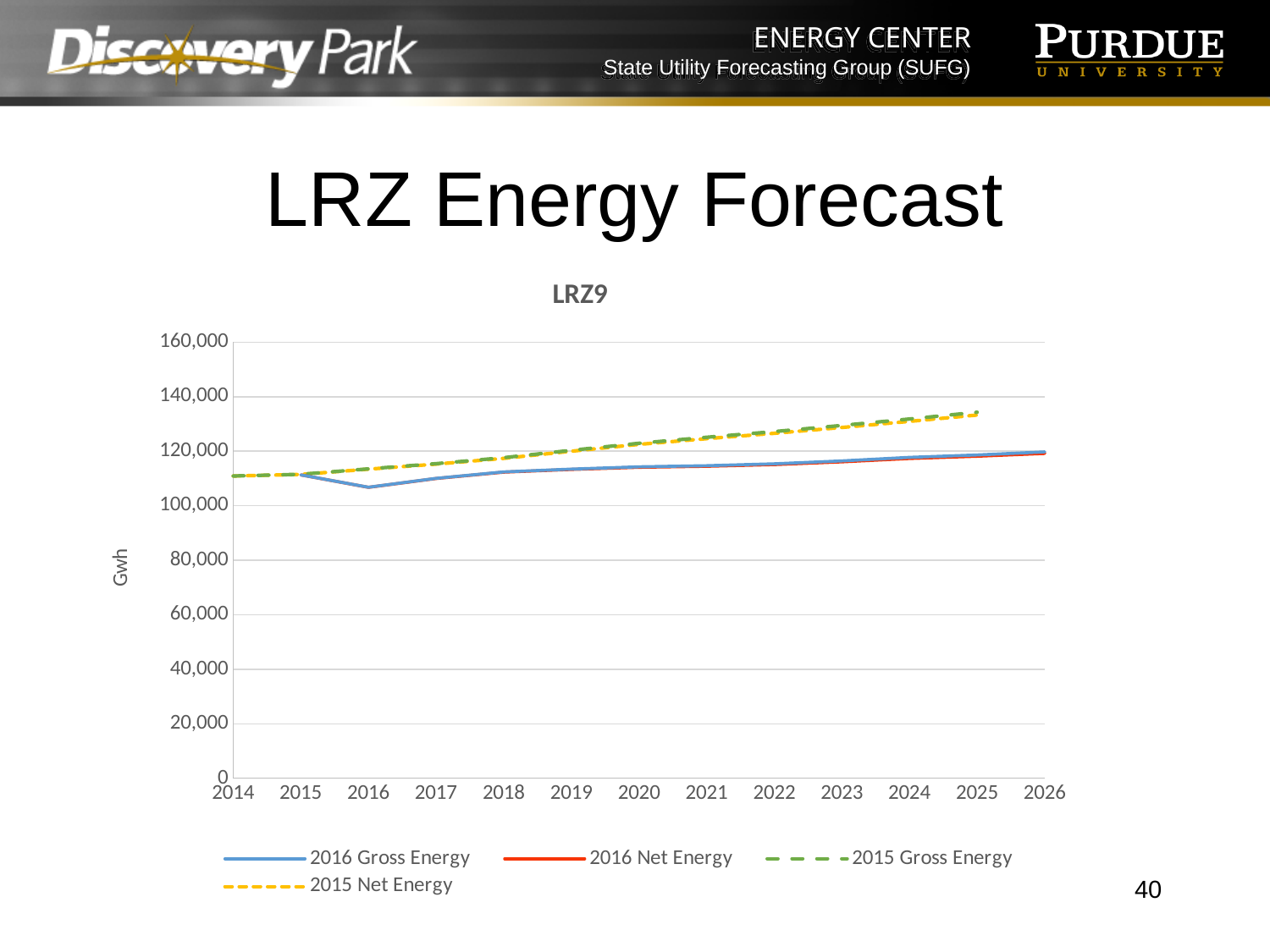
What is the title of the chart? LRZ9 Is the value for 2015 Gross Energy in 2025 greater or less than 140,000? less How many series does the legend list? 4 What kind of chart is shown on the slide? line chart Does the 2016 Net Energy series rise or fall from 2016 to 2026? rise Does the 2015 Gross Energy series rise or fall from 2014 to 2025? rise In 2025, which is larger: 2015 Gross Energy or 2016 Gross Energy? 2015 Gross Energy In which year is the 2016 Gross Energy series at its lowest? 2016 What is the label on the y axis? Gwh How many years are marked on the x axis? 13 Is the value for 2015 Net Energy in 2025 greater or less than 120,000? greater Is the value for 2016 Gross Energy in 2016 greater or less than 100,000? greater